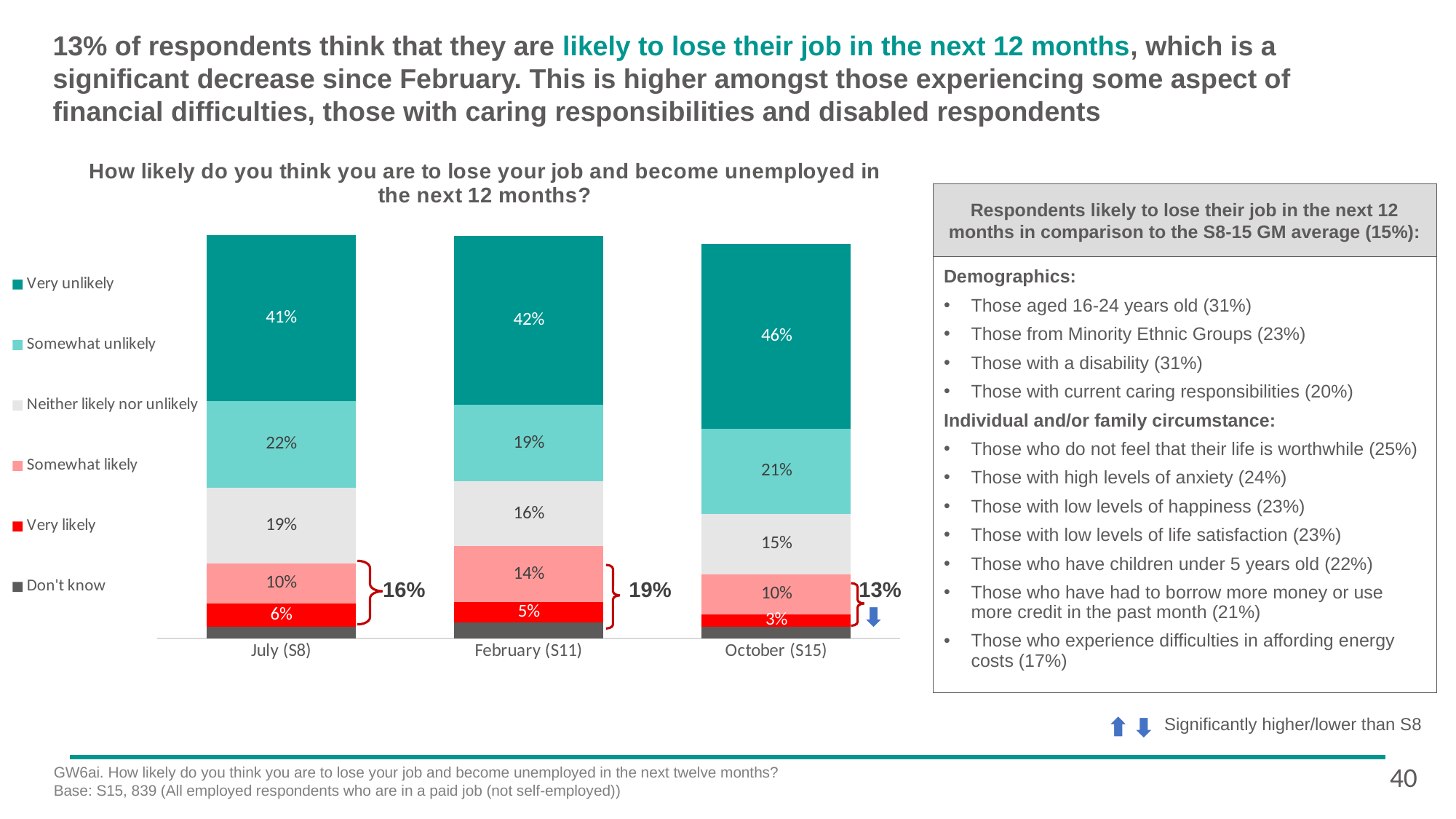
In which survey wave is the 'Very likely' share lowest? October (S15) How many survey waves (bars) are shown on the chart? 3 What is the combined 'likely' percentage (Somewhat likely plus Very likely) shown for February (S11)? 19% What percentage of respondents said 'Very unlikely' in October (S15)? 46% What percentage of respondents said 'Very likely' in July (S8)? 6% How does the combined 'likely' percentage change from February (S11) to October (S15)? It falls from 19% to 13% What percentage of respondents said 'Somewhat likely' in February (S11)? 14% How many series does the chart legend list? 6 What kind of chart is shown on the slide? Stacked bar chart Which is larger: the 'Somewhat unlikely' share in July (S8) or in February (S11)? July (S8) In which survey wave is the 'Very unlikely' share highest? October (S15) What is the difference between the 'Neither likely nor unlikely' share in July (S8) and in October (S15)? 4 percentage points